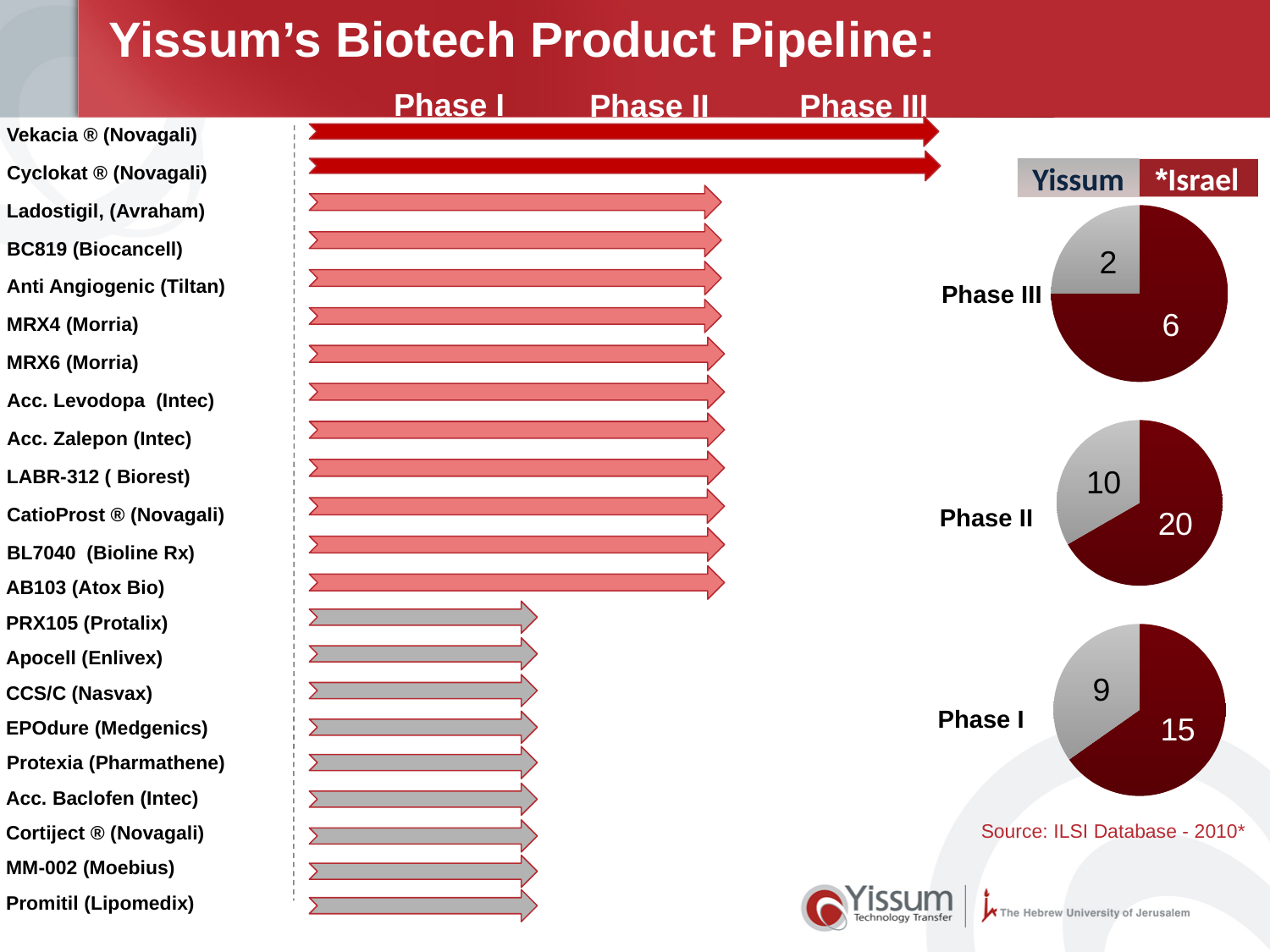
How many series does the legend above the pie charts list? 2 According to the legend above the pie charts, which series is shown in dark red? *Israel In the Phase III pie chart, what share of the total does the Yissum slice represent? 25% In the Phase II pie chart, what is the value for Israel? 20 In the Phase II pie chart, what is the value for Yissum? 10 In the Phase I pie chart, what is the difference between the Israel value and the Yissum value? 6 What kind of chart is used to show the Phase I, Phase II and Phase III figures on the right of the slide? Pie chart In the Phase I pie chart, what is the value for Israel? 15 In the Phase II pie chart, which is larger, the Yissum slice or the Israel slice? Israel In the Phase III pie chart, what is the value for Israel? 6 What is the total of the two values shown in the Phase II pie chart? 30 In the Phase III pie chart, what is the value for Yissum? 2